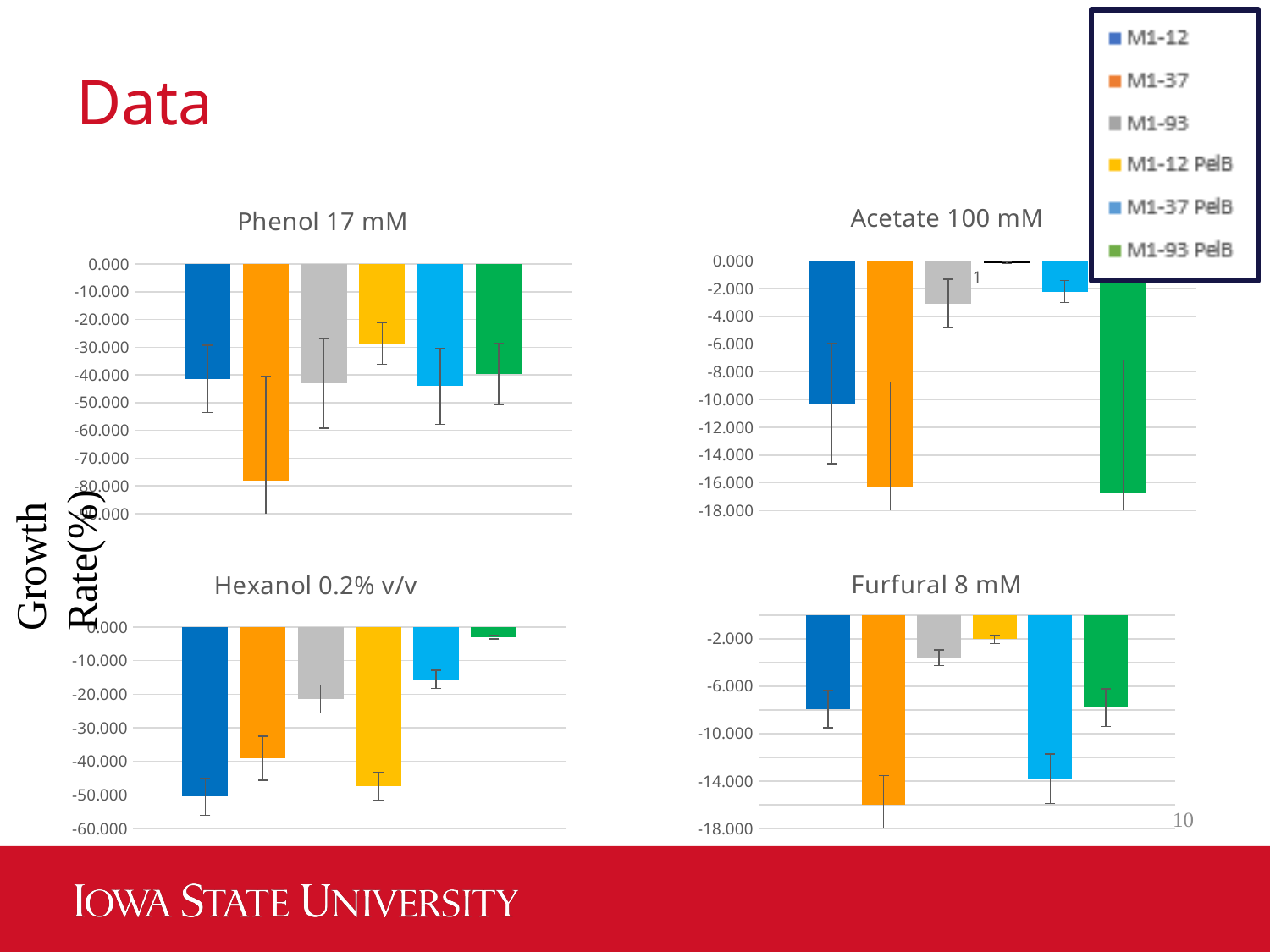
In the Furfural 8 mM chart, is the value for M1-37 PelB greater or less than -10.000? less In the Hexanol 0.2% v/v chart, is the value for M1-37 PelB greater or less than -20.000? greater In the Hexanol 0.2% v/v chart, which series has the highest (least negative) growth rate? M1-93 PelB How many bars are plotted in the Furfural 8 mM chart? 6 What kind of chart is the Phenol 17 mM chart? bar chart In the Hexanol 0.2% v/v chart, which is larger, the value for M1-93 or the value for M1-37? M1-93 In the Furfural 8 mM chart, which series has the lowest (most negative) growth rate? M1-37 In the Phenol 17 mM chart, is the value for M1-37 greater or less than -70.000? less How many series does the legend list? 6 In the Acetate 100 mM chart, which series has the highest (least negative) growth rate? M1-12 PelB In the Phenol 17 mM chart, which series has the lowest (most negative) growth rate? M1-37